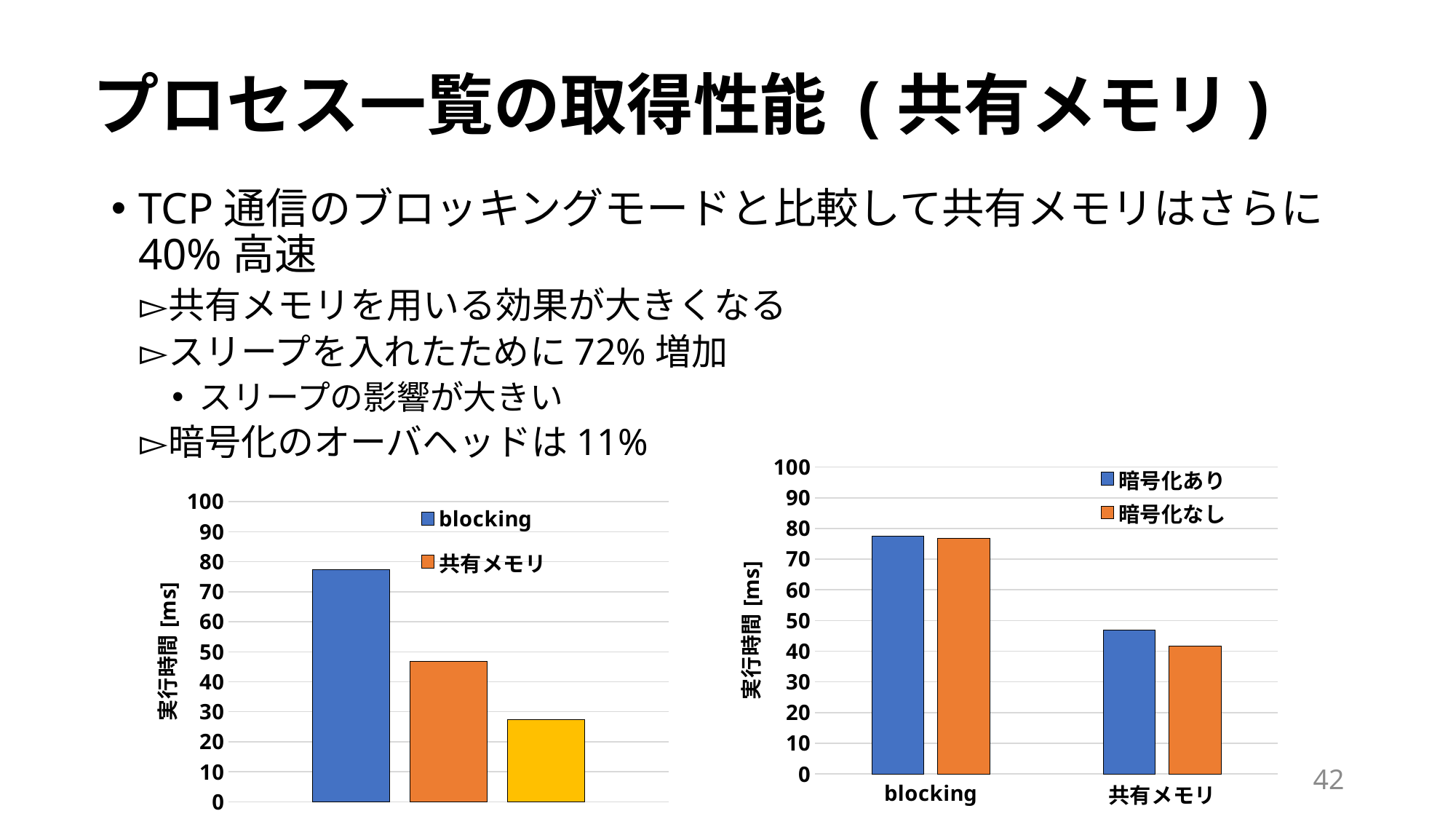
In the left chart, which is larger, blocking or 共有メモリ? blocking What kind of chart is the left chart? bar chart In the left chart, which bar is the highest? blocking In the left chart, is the value for 共有メモリ greater or less than 50? less In the left chart, is the value for blocking greater or less than 70? greater In the right chart, is the 暗号化あり value for blocking greater or less than 70? greater In the right chart, which category has the highest 暗号化あり value? blocking How many series does the legend of the right chart list? 2 How many categories are shown on the x axis of the right chart? 2 In the right chart, for 共有メモリ, which is larger, 暗号化あり or 暗号化なし? 暗号化あり In the left chart, what is the y-axis label? 実行時間 [ms]